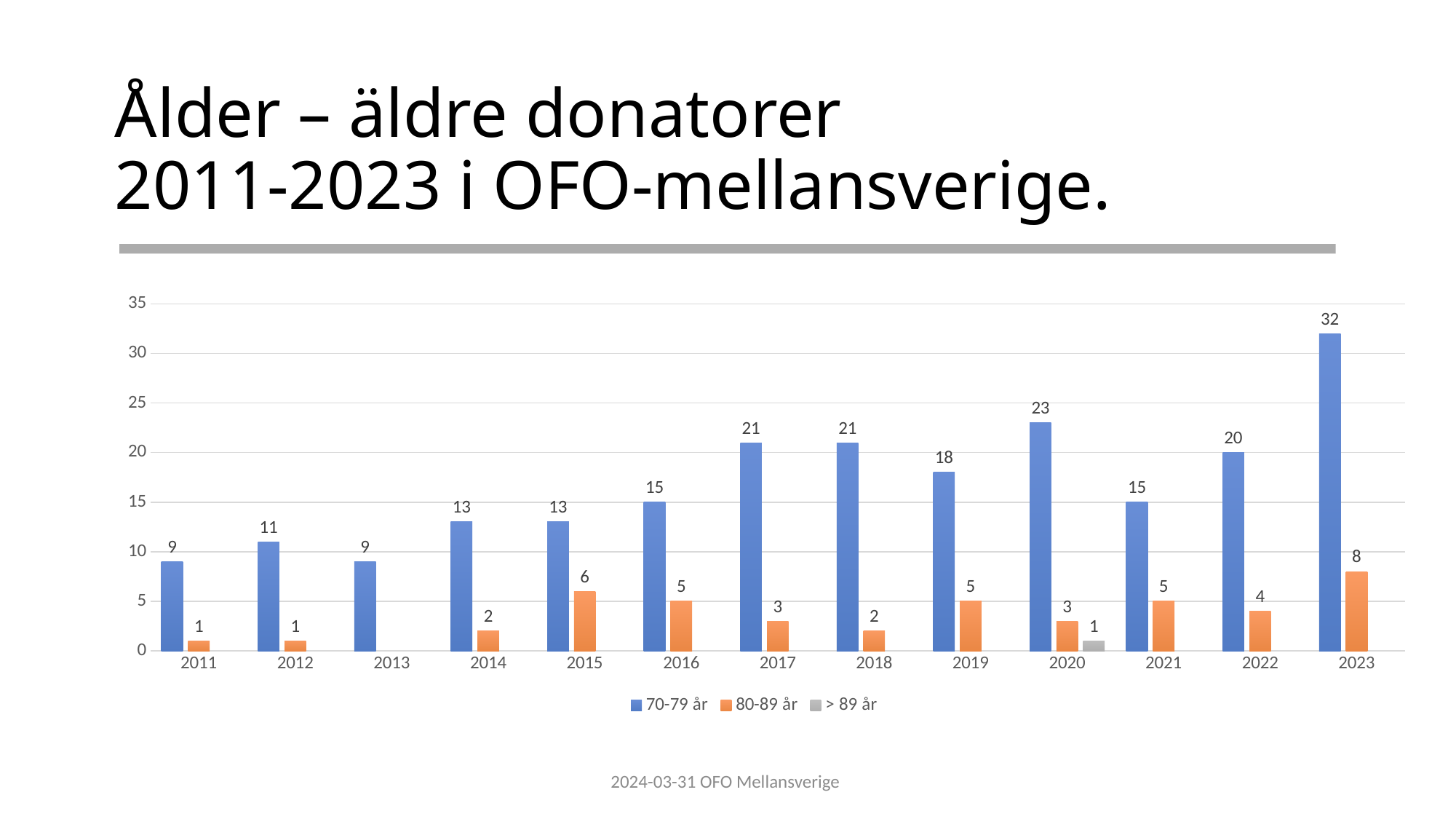
What is the value for the > 89 år series in 2020? 1 Which is larger, the 70-79 år value for 2019 or for 2020? 2020 What colour are the bars for the 80-89 år series? orange What is the value for the 70-79 år series in 2023? 32 How many series does the legend list? 3 What kind of chart is shown on the slide? bar chart What is the value for the 80-89 år series in 2015? 6 What is the difference between the 70-79 år values for 2023 and 2022? 12 How many years are shown on the x axis? 13 Which year has the highest value for the 70-79 år series? 2023 Which year has the highest value for the 80-89 år series? 2023 What is the difference between the 70-79 år and 80-89 år values in 2016? 10